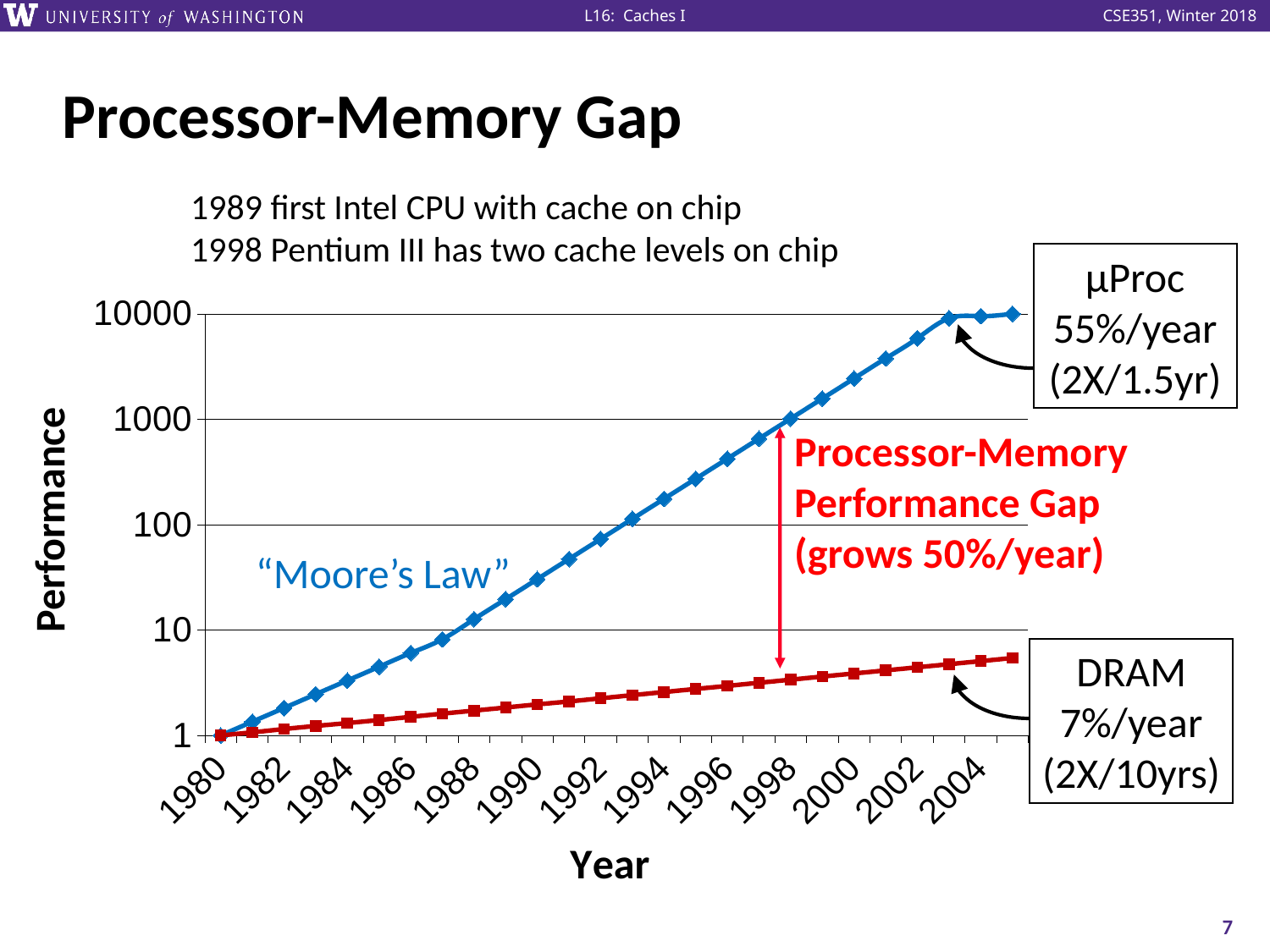
Is the µProc value in 2004 greater or less than 1000? greater Is the µProc value in 1990 greater or less than 10? greater How many year labels are shown along the x axis? 13 What kind of chart is shown on the slide? line chart Is the µProc value in 1986 greater or less than 10? less How many data series are plotted in the chart? 2 Does the DRAM performance rise or fall from 1980 to 2004? rise What is the label on the y axis of the chart? Performance In 2000, which series has the higher performance value, µProc or DRAM? µProc What is the label on the x axis of the chart? Year